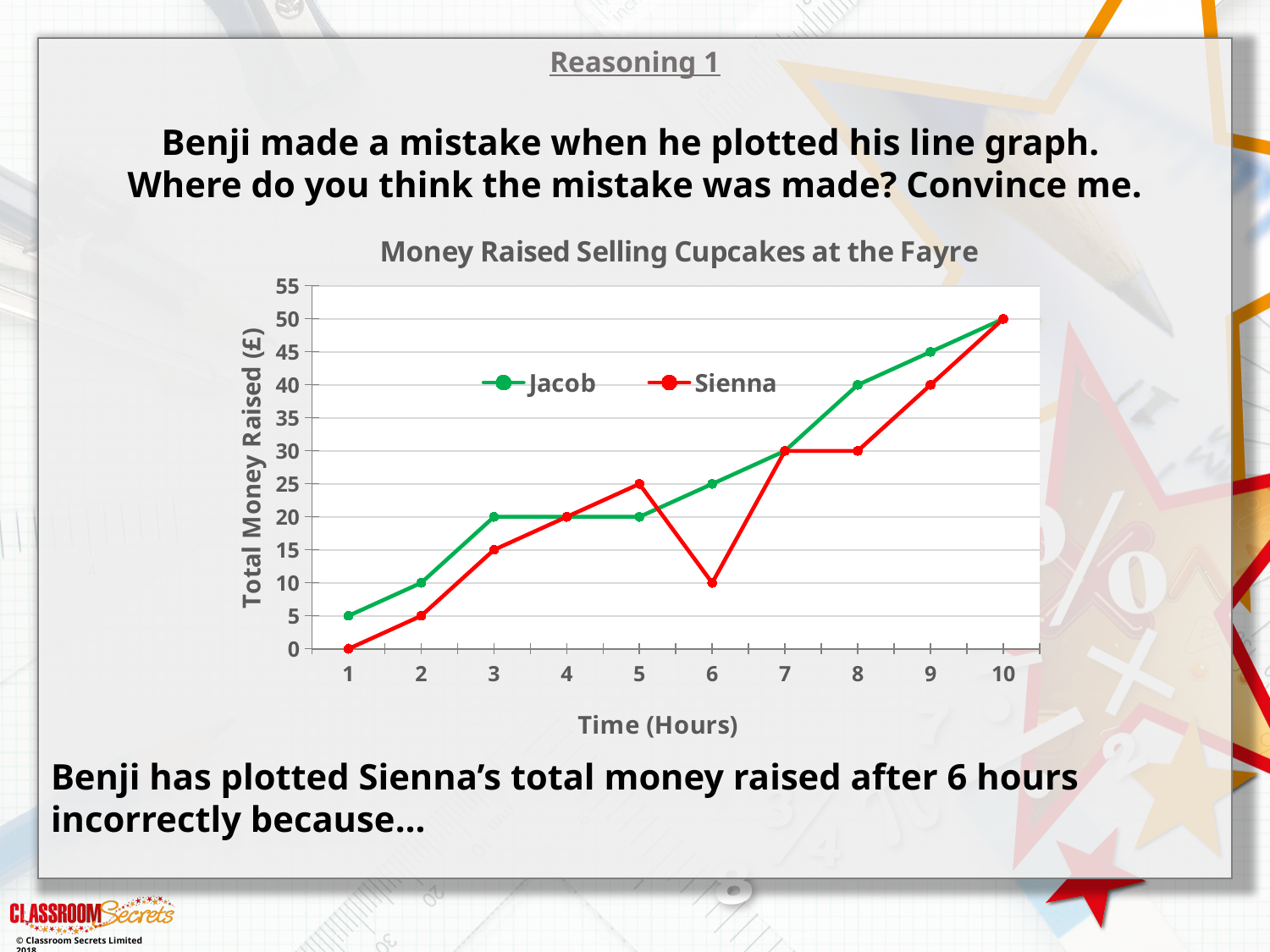
How many series does the legend list? 2 Does Jacob's total money raised generally rise or fall as time increases? rise What type of chart is shown on the slide? line chart At which hour is Sienna's total money raised the lowest? 1 What is Sienna's total money raised after 6 hours? 10 What is the difference between Jacob's and Sienna's total money raised after 6 hours? 15 What is Sienna's total money raised after 1 hour? 0 After 5 hours, who has raised more money, Jacob or Sienna? Sienna What is Jacob's total money raised after 3 hours? 20 How many time points are plotted along the x axis? 10 What is the title of the chart? Money Raised Selling Cupcakes at the Fayre At which hour is Jacob's total money raised the highest? 10